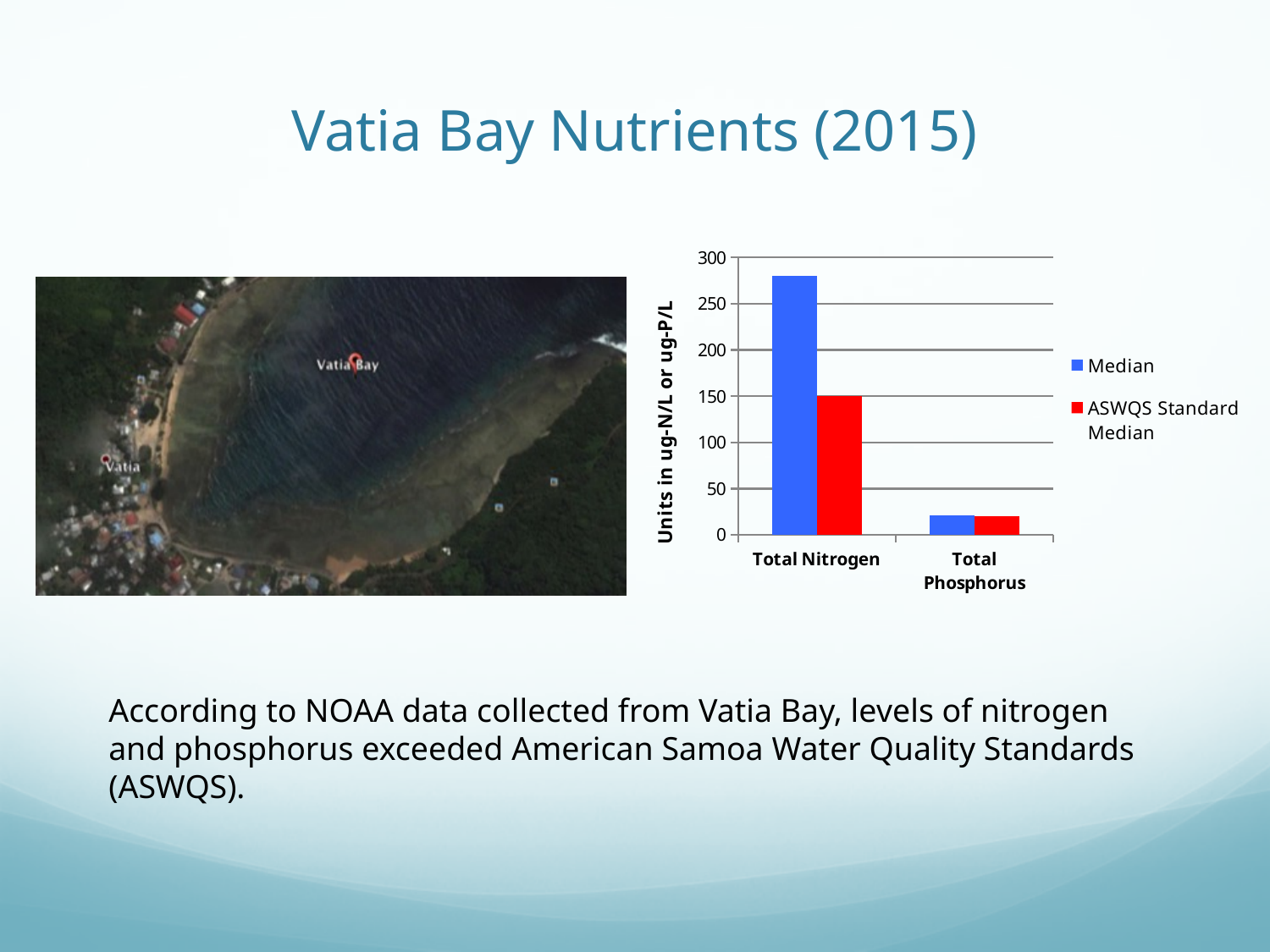
How many categories are shown on the x axis of the chart? 2 Is the ASWQS Standard Median value for Total Nitrogen greater or less than 100? greater What is the label on the chart's vertical axis? Units in ug-N/L or ug-P/L What kind of chart is shown on the slide? bar chart For Total Nitrogen, which is larger: the Median or the ASWQS Standard Median? Median What colour are the ASWQS Standard Median bars in the chart? red How many series does the chart's legend list? 2 Is the Median value for Total Nitrogen greater or less than 250? greater Is the ASWQS Standard Median value for Total Nitrogen greater or less than 200? less Which bar in the chart is the tallest? Median for Total Nitrogen Which category has the higher Median value, Total Nitrogen or Total Phosphorus? Total Nitrogen